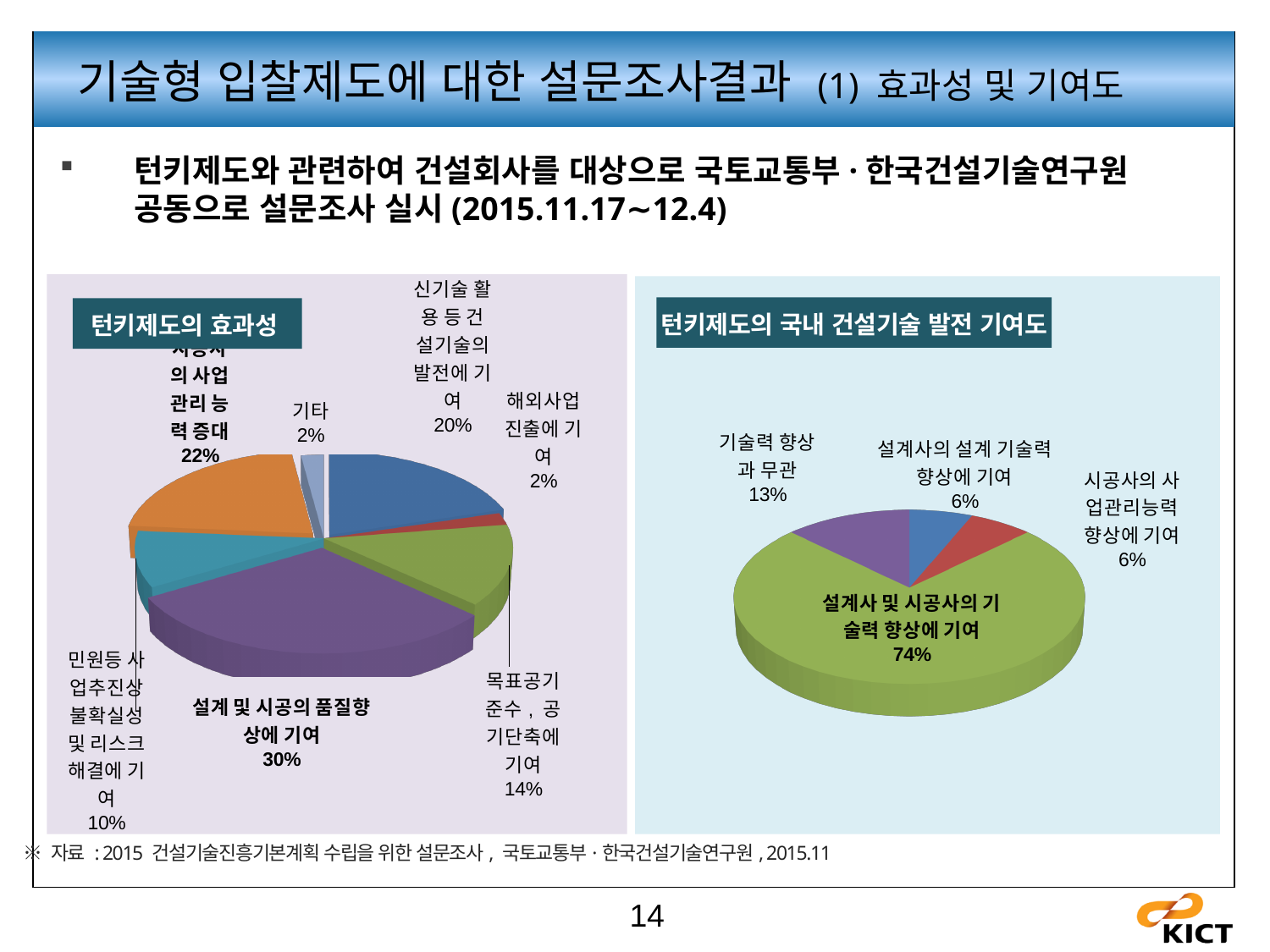
How many slices does the chart titled 턴키제도의 국내 건설기술 발전 기여도 have? 4 In the chart titled 턴키제도의 국내 건설기술 발전 기여도, what percentage is shown for 기술력 향상과 무관? 13% How many slices does the chart titled 턴키제도의 효과성 have? 7 In the chart titled 턴키제도의 국내 건설기술 발전 기여도, what is the difference in percentage points between 설계사 및 시공사의 기술력 향상에 기여 and 기술력 향상과 무관? 61 In the chart titled 턴키제도의 효과성, what is the difference in percentage points between 설계 및 시공의 품질향상에 기여 and 신기술 활용 등 건설기술의 발전에 기여? 10 In the chart titled 턴키제도의 국내 건설기술 발전 기여도, what percentage is shown for 설계사 및 시공사의 기술력 향상에 기여? 74% In the chart titled 턴키제도의 효과성, which is larger: 신기술 활용 등 건설기술의 발전에 기여 or 민원등 사업추진상 불확실성 및 리스크 해결에 기여? 신기술 활용 등 건설기술의 발전에 기여 How many pie charts are shown on the slide? 2 In the chart titled 턴키제도의 효과성, what percentage is shown for 설계 및 시공의 품질향상에 기여? 30% In the chart titled 턴키제도의 효과성, which category has the largest share? 설계 및 시공의 품질향상에 기여 What type of chart is the chart titled 턴키제도의 국내 건설기술 발전 기여도? Pie chart In the chart titled 턴키제도의 효과성, what percentage is shown for 목표공기 준수, 공기단축에 기여? 14%